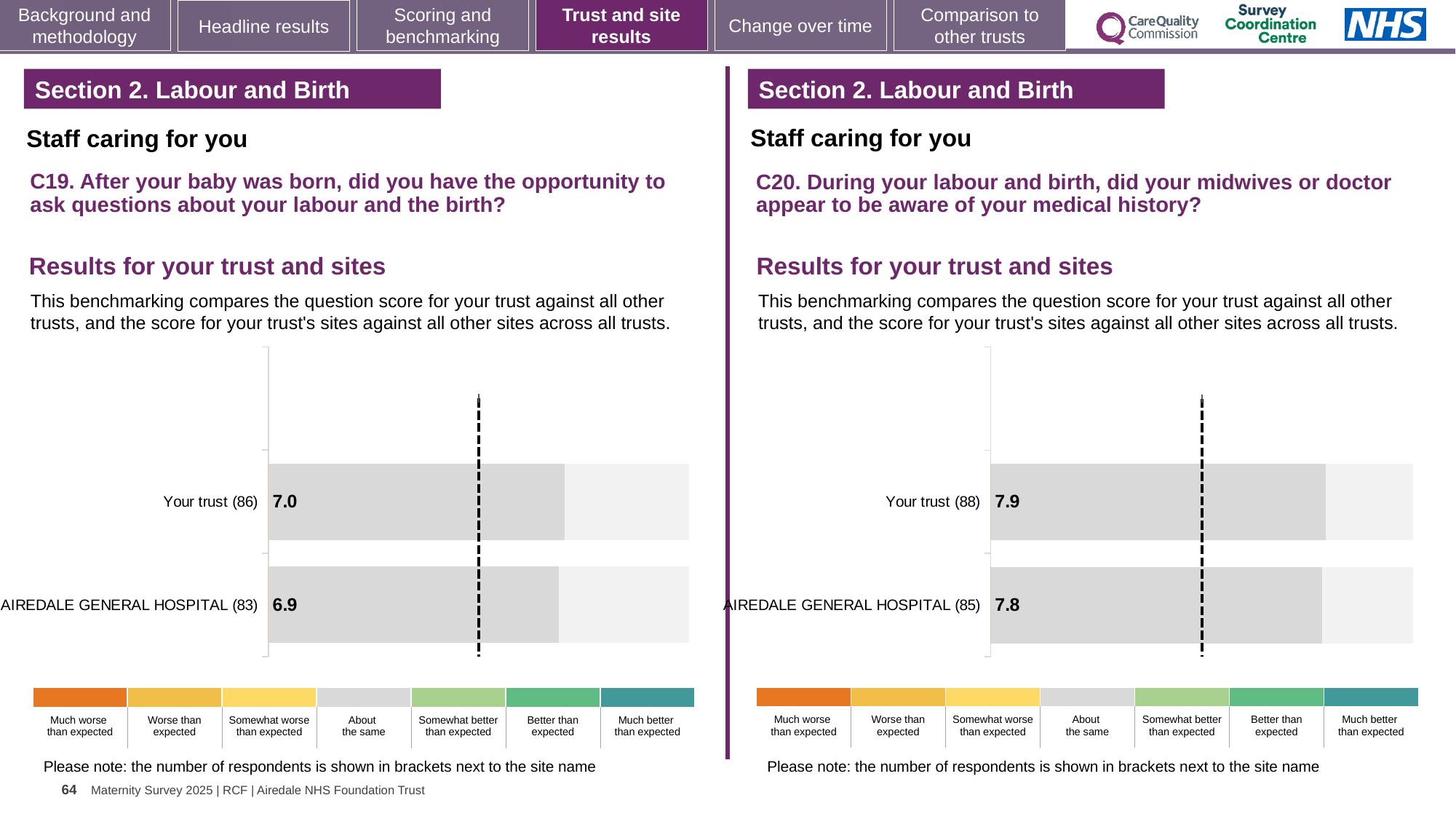
In the C20 chart on the right, what is the score for Your trust? 7.9 In the C19 chart on the left, how many respondents are shown in brackets for Your trust? 86 In the C19 chart on the left, what is the score for AIREDALE GENERAL HOSPITAL? 6.9 In the C19 chart on the left, what is the score for Your trust? 7.0 How many categories does the colour key below the C19 chart on the left list? 7 In the C20 chart on the right, what is the score for AIREDALE GENERAL HOSPITAL? 7.8 In the C20 chart on the right, what is the difference between the Your trust score and the AIREDALE GENERAL HOSPITAL score? 0.1 How many bars are plotted in the C19 chart on the left? 2 In the C19 chart on the left, what is the difference between the Your trust score and the AIREDALE GENERAL HOSPITAL score? 0.1 In the C20 chart on the right, how many respondents are shown in brackets for AIREDALE GENERAL HOSPITAL? 85 How many bars are plotted in the C20 chart on the right? 2 What kind of chart is used for the C20 results on the right? Bar chart